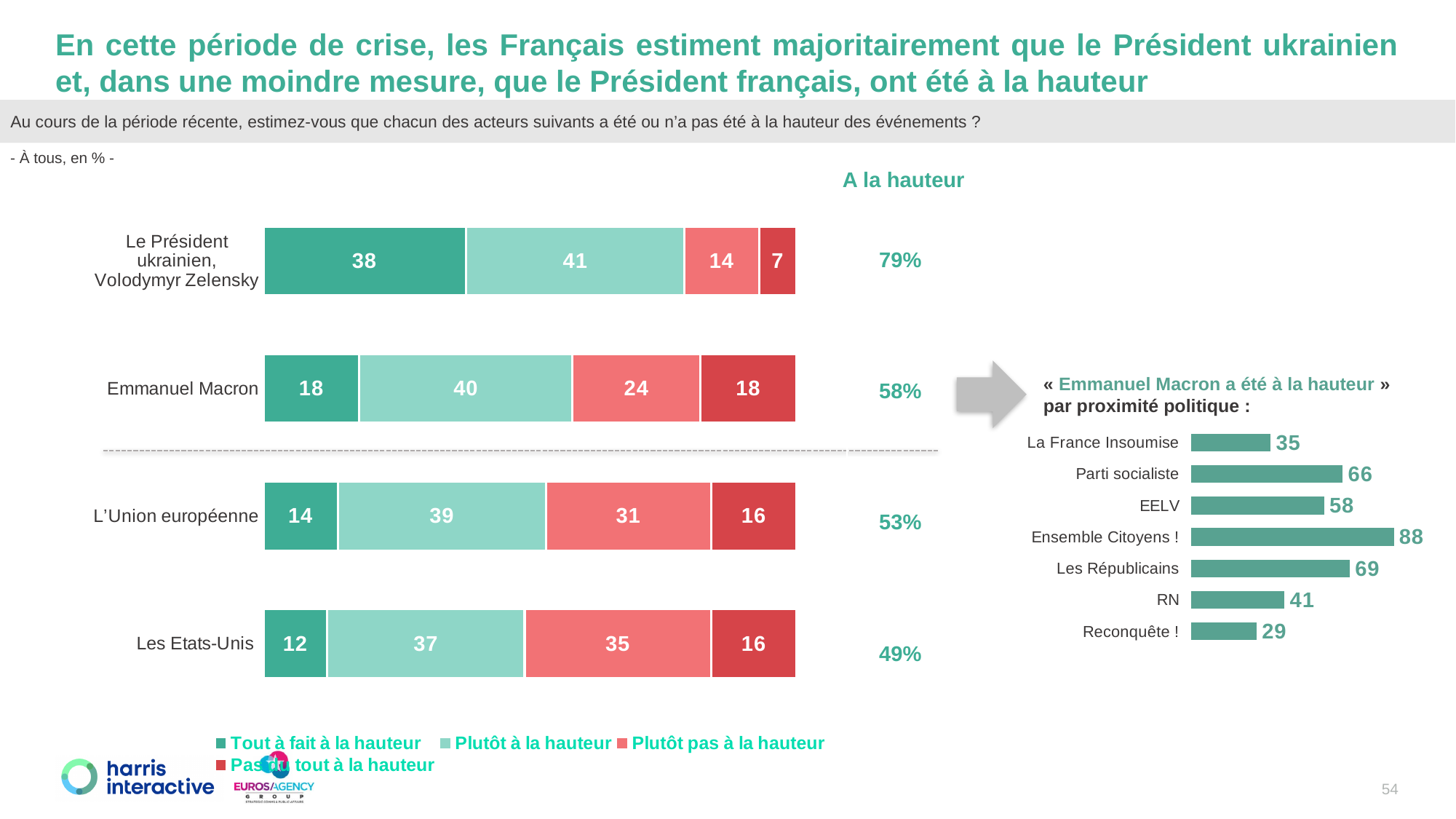
In the main stacked bar chart on the left, what is the value of "Plutôt pas à la hauteur" for Les Etats-Unis? 35 In the chart on the right, "Emmanuel Macron a été à la hauteur" par proximité politique, how many political groups are listed? 7 In the main stacked bar chart on the left, how many actors are shown? 4 In the chart on the right, "Emmanuel Macron a été à la hauteur" par proximité politique, what is the value for Les Républicains? 69 In the main stacked bar chart on the left, what is the "A la hauteur" total shown for Emmanuel Macron? 58% In the main stacked bar chart on the left, which actor has the highest "Tout à fait à la hauteur" value? Le Président ukrainien, Volodymyr Zelensky In the main stacked bar chart on the left, what is the value of "Tout à fait à la hauteur" for Le Président ukrainien, Volodymyr Zelensky? 38 In the main stacked bar chart on the left, what is the difference between the "Plutôt pas à la hauteur" values for L'Union européenne and Emmanuel Macron? 7 In the chart on the right, "Emmanuel Macron a été à la hauteur" par proximité politique, which is larger: the value for Parti socialiste or the value for EELV? Parti socialiste In the chart on the right, "Emmanuel Macron a été à la hauteur" par proximité politique, which group has the highest value? Ensemble Citoyens ! In the main stacked bar chart on the left, how many series does the legend list? 4 In the main stacked bar chart on the left, which actor has the lowest "A la hauteur" percentage? Les Etats-Unis